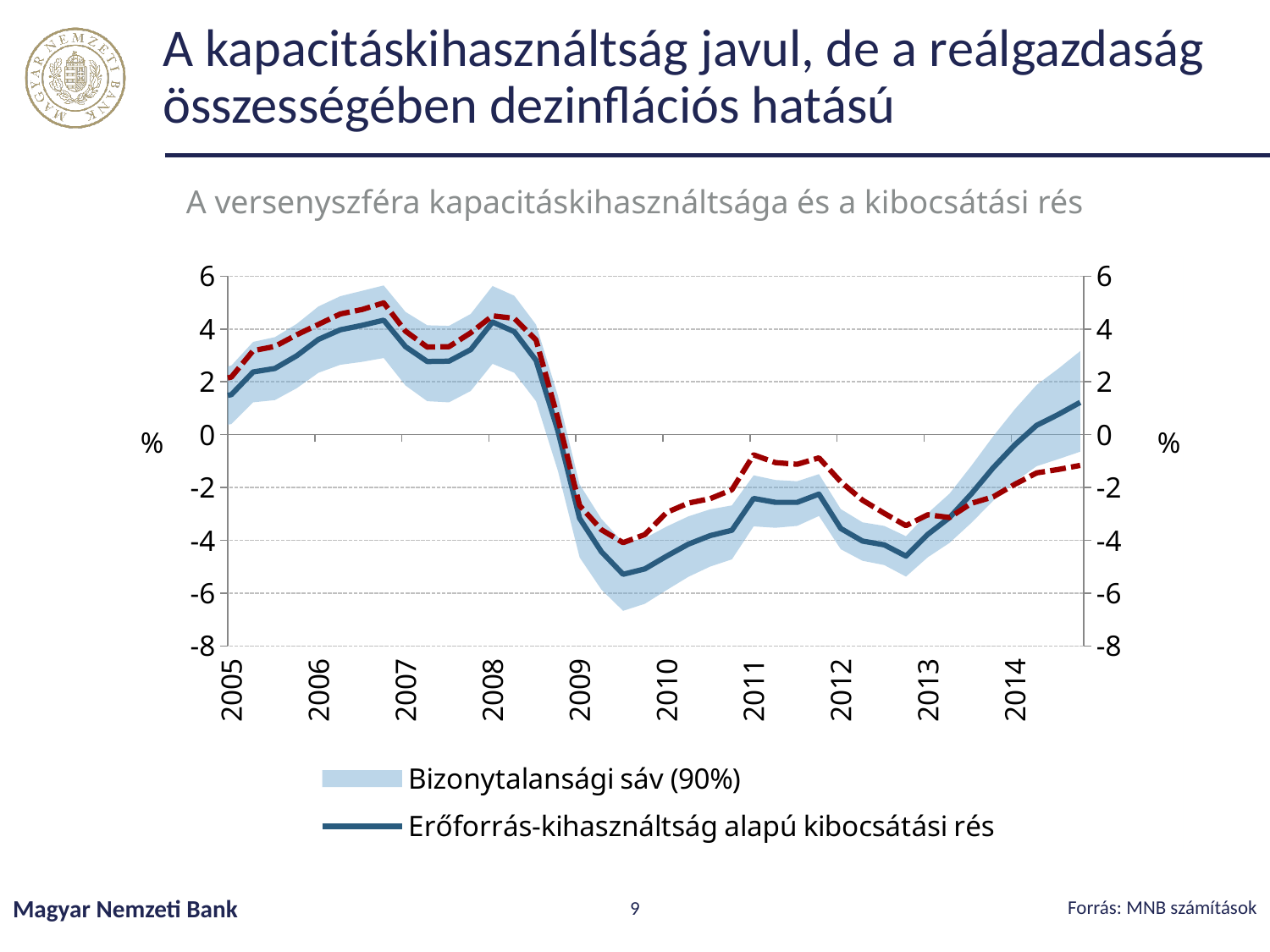
Is the value of the solid line (Erőforrás-kihasználtság alapú kibocsátási rés) at 2009 greater or less than 0? less How many entries does the chart legend list? 2 Does the solid line (Erőforrás-kihasználtság alapú kibocsátási rés) rise or fall between 2013 and 2014? rise In which year does the solid line (Erőforrás-kihasználtság alapú kibocsátási rés) reach its lowest point? 2009 Is the value of the solid line (Erőforrás-kihasználtság alapú kibocsátási rés) at 2010 greater or less than -2? less Is the value of the solid line (Erőforrás-kihasználtság alapú kibocsátási rés) at 2014 greater or less than -2? greater What is the title of the chart? A versenyszféra kapacitáskihasználtsága és a kibocsátási rés What kind of chart is shown on the slide? combination area and line chart Does the solid line (Erőforrás-kihasználtság alapú kibocsátási rés) rise or fall between 2008 and 2009? fall How many year labels are shown on the x axis? 10